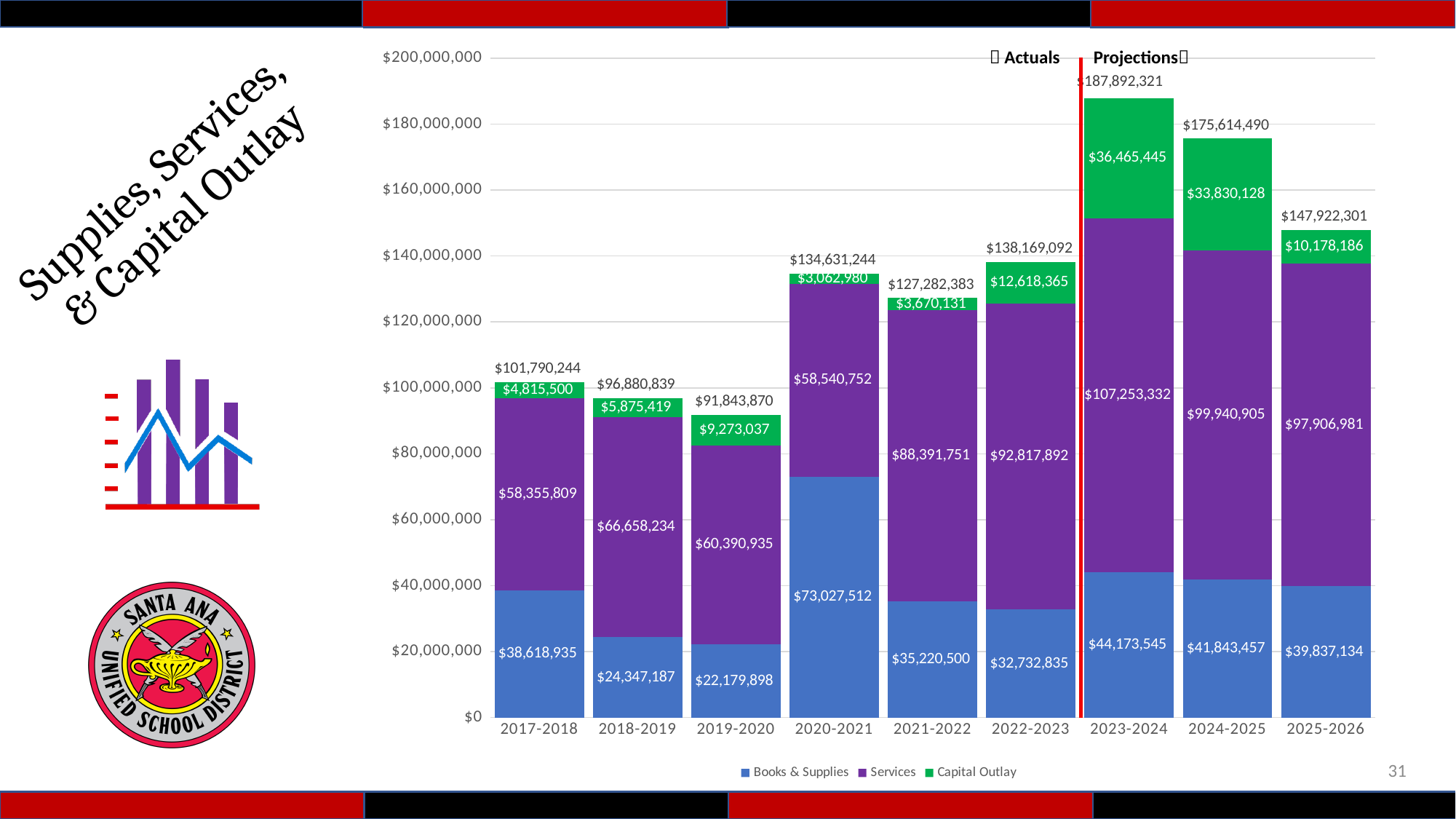
Which is larger, the Books & Supplies value for 2017-2018 or for 2021-2022? 2017-2018 How many series does the legend list? 3 What is the Capital Outlay value for 2023-2024? $36,465,445 Which year has the highest total bar? 2023-2024 How many fiscal years are shown on the x axis? 9 What is the total of the stacked bar for 2022-2023? $138,169,092 What is the Books & Supplies value for 2020-2021? $73,027,512 Which year has the lowest total bar? 2019-2020 What is the difference between the Services value for 2023-2024 and for 2024-2025? $7,312,427 Which year has the lowest Capital Outlay value? 2020-2021 What kind of chart is shown on the slide? Stacked bar chart What is the Services value for 2019-2020? $60,390,935